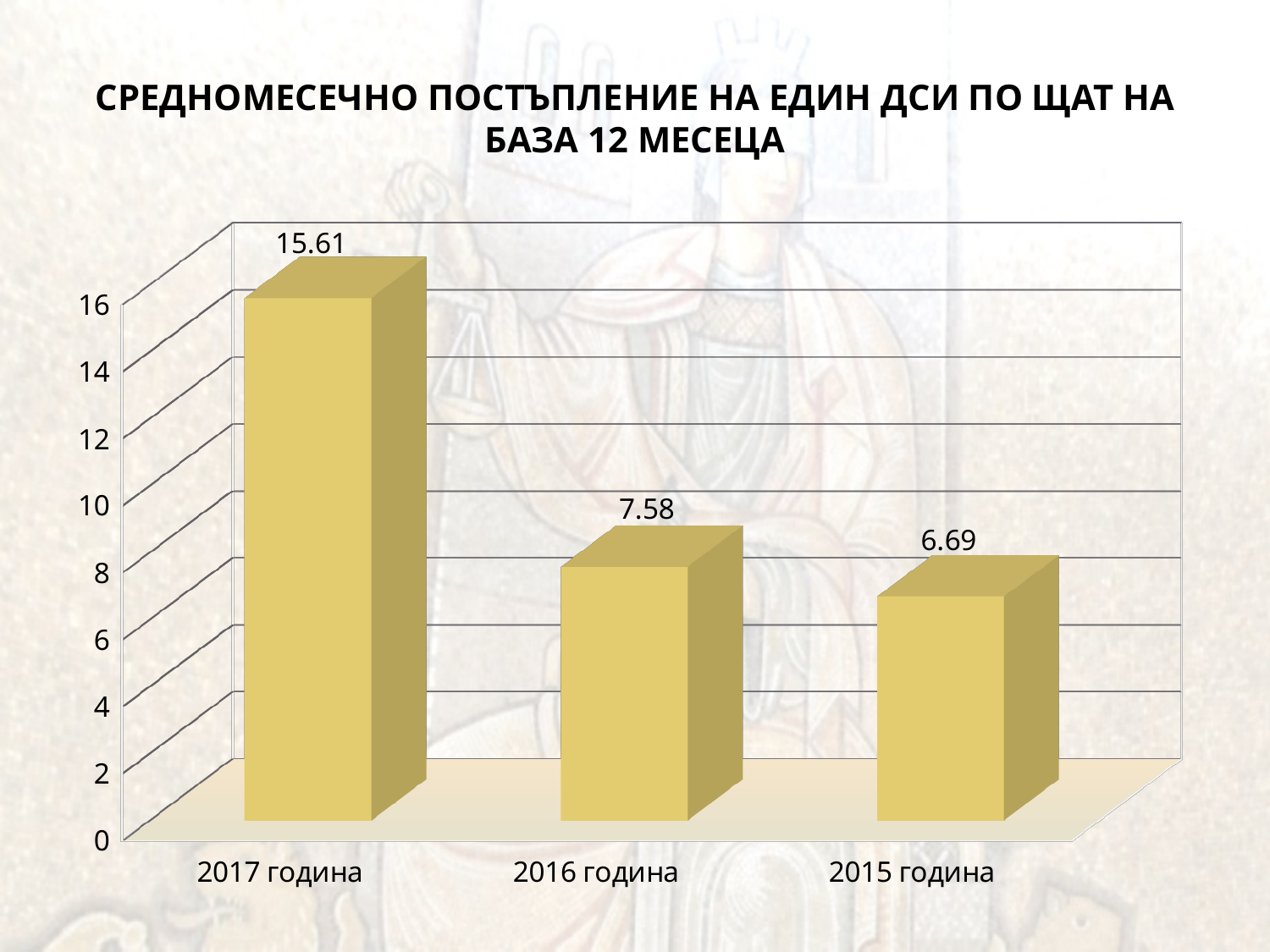
What kind of chart is shown on the slide? bar chart What is the value for 2015 година? 6.69 Which is larger, the value for 2016 година or 2015 година? 2016 година Which year has the highest value? 2017 година Which year has the lowest value? 2015 година What is the title of the chart? СРЕДНОМЕСЕЧНО ПОСТЪПЛЕНИЕ НА ЕДИН ДСИ ПО ЩАТ НА БАЗА 12 МЕСЕЦА What is the difference between the values for 2016 година and 2015 година? 0.89 What is the value for 2017 година? 15.61 What is the difference between the values for 2017 година and 2016 година? 8.03 What is the value for 2016 година? 7.58 How many categories are shown on the chart? 3 Is the value for 2017 година greater or less than 14? greater